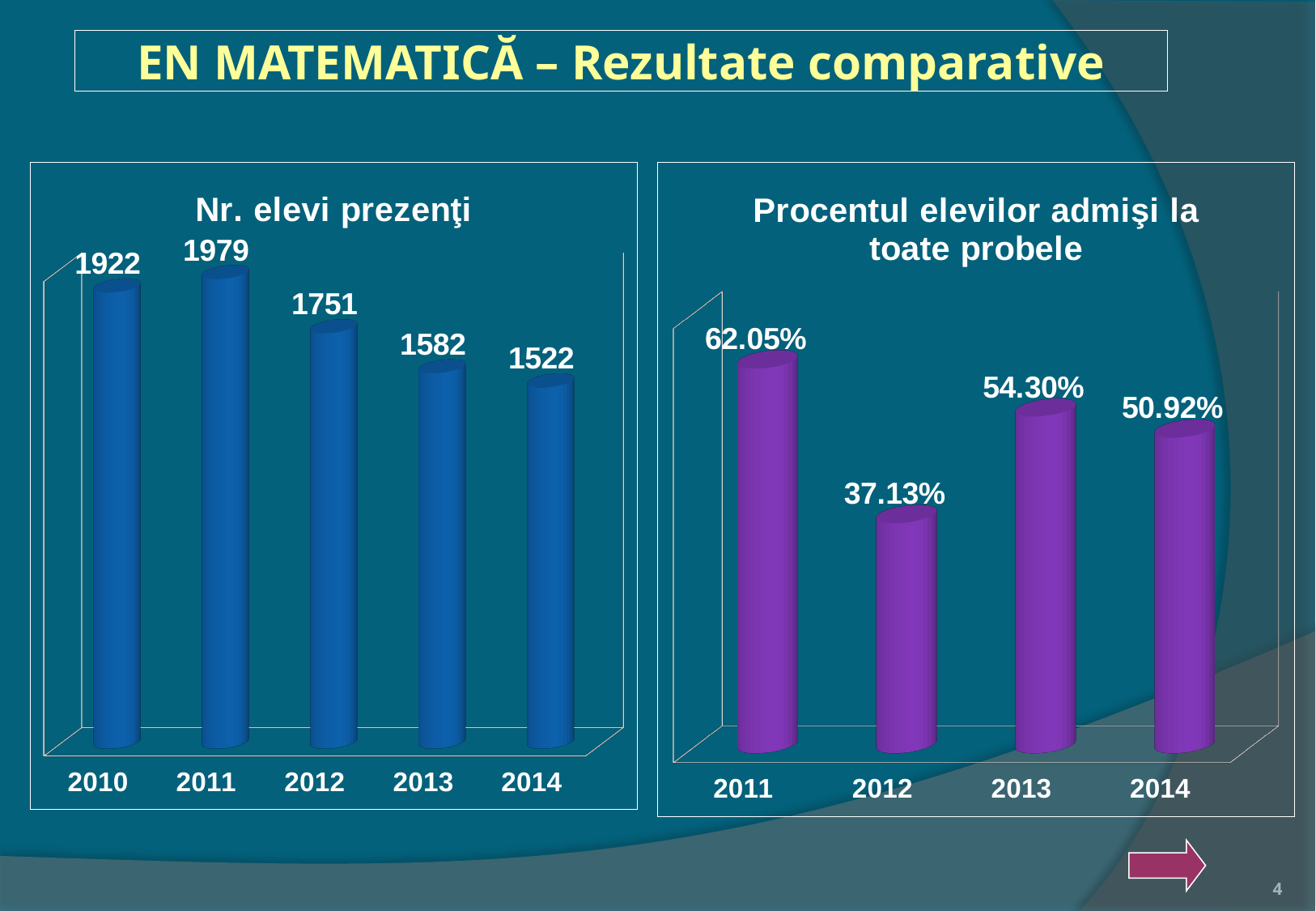
In the 'Procentul elevilor admişi la toate probele' chart, which year has the highest value? 2011 In the 'Nr. elevi prezenţi' chart, what is the value for 2012? 1751 In the 'Nr. elevi prezenţi' chart, what is the difference between the values for 2011 and 2014? 457 In the 'Procentul elevilor admişi la toate probele' chart, which year has the lowest value? 2012 In the 'Nr. elevi prezenţi' chart, do the values rise or fall from 2011 to 2014? fall In the 'Nr. elevi prezenţi' chart, how many years are shown? 5 In the 'Procentul elevilor admişi la toate probele' chart, what is the value for 2012? 37.13% In the 'Nr. elevi prezenţi' chart, which year has the lowest value? 2014 What type of chart is the 'Procentul elevilor admişi la toate probele' chart? bar chart In the 'Procentul elevilor admişi la toate probele' chart, how many years are shown? 4 In the 'Procentul elevilor admişi la toate probele' chart, is the value for 2013 or 2014 larger? 2013 In the 'Nr. elevi prezenţi' chart, which year has the highest value? 2011